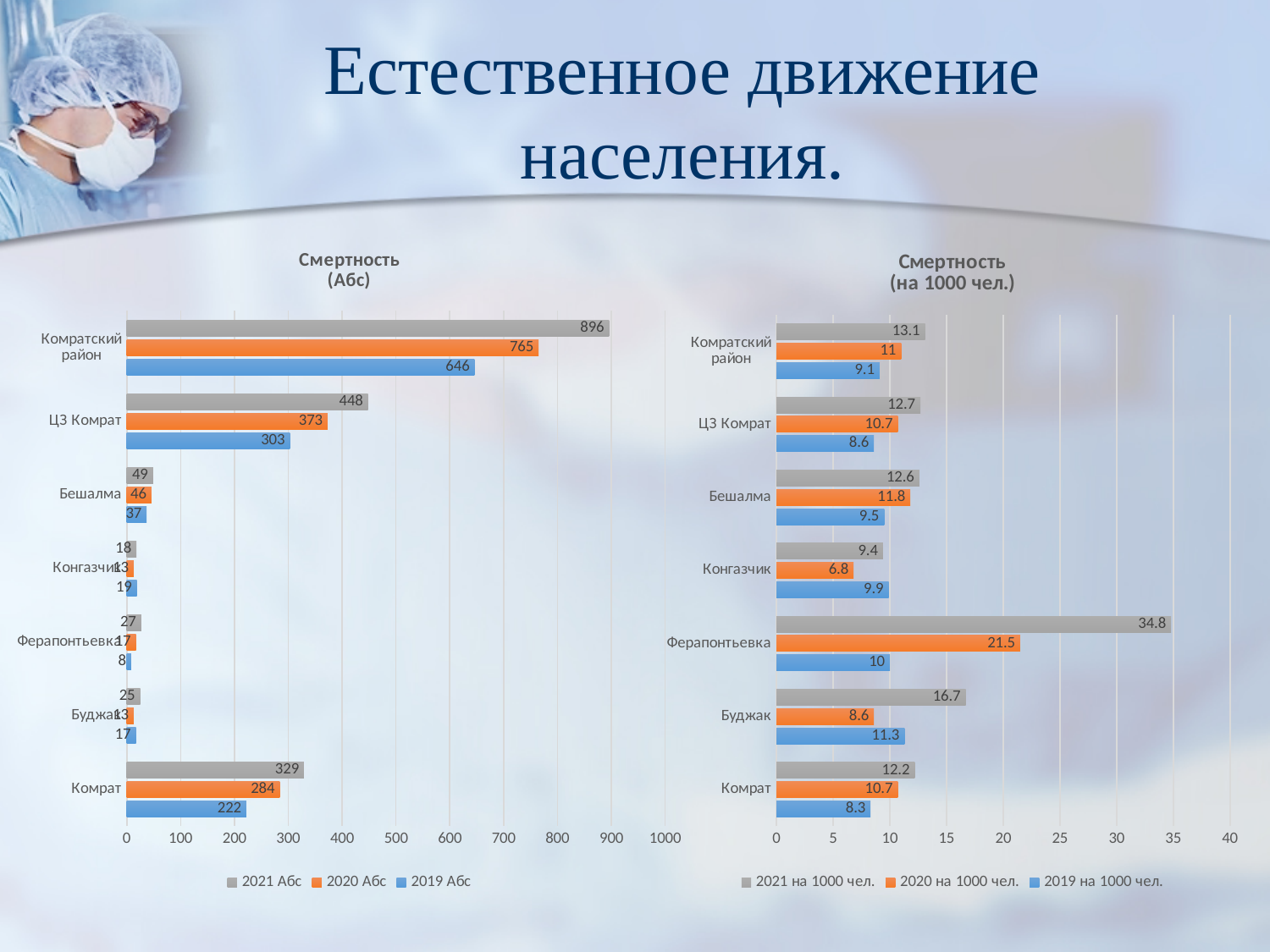
In the chart titled 'Смертность (Абс)', what is the difference between the 2021 Абс and 2019 Абс values for ЦЗ Комрат? 145 In the chart titled 'Смертность (на 1000 чел.)', which is larger for Буджак: the 2020 на 1000 чел. value or the 2019 на 1000 чел. value? 2019 на 1000 чел. In the chart titled 'Смертность (на 1000 чел.)', is the 2021 на 1000 чел. value for Ферапонтьевка greater or less than 30? greater In the chart titled 'Смертность (на 1000 чел.)', which category has the lowest 2020 на 1000 чел. value? Конгазчик In the chart titled 'Смертность (на 1000 чел.)', how many categories are shown on the vertical axis? 7 In the chart titled 'Смертность (Абс)', what is the value for Комрат in the 2019 Абс series? 222 In the chart titled 'Смертность (Абс)', what is the value for Комратский район in the 2021 Абс series? 896 In the chart titled 'Смертность (на 1000 чел.)', what is the value for Конгазчик in the 2020 на 1000 чел. series? 6.8 In the chart titled 'Смертность (Абс)', which category has the highest 2021 Абс value? Комратский район In the chart titled 'Смертность (на 1000 чел.)', what is the value for Ферапонтьевка in the 2021 на 1000 чел. series? 34.8 In the chart titled 'Смертность (Абс)', how many series does the legend list? 3 What kind of chart is the chart titled 'Смертность (Абс)'? Bar chart